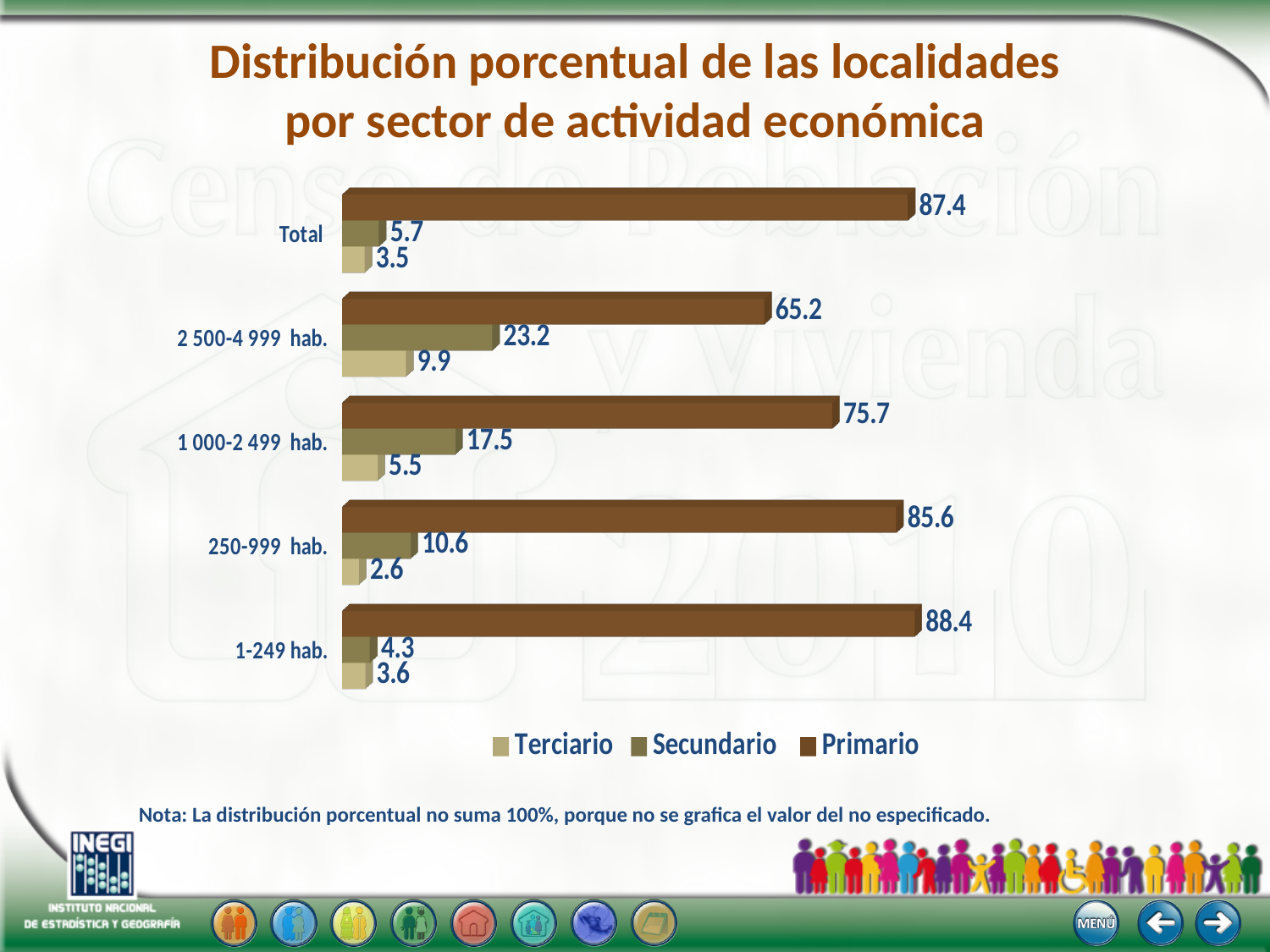
What is the Primario value for localities of 1 000-2 499 hab.? 75.7 How many series does the legend list? 3 Which is larger: the Secundario value for 1 000-2 499 hab. or the Secundario value for 250-999 hab.? 1 000-2 499 hab. What is the Primario value for the Total category? 87.4 Which series is shown in dark brown in the legend? Primario What is the Secundario value for localities of 2 500-4 999 hab.? 23.2 What is the Terciario value for localities of 250-999 hab.? 2.6 Which locality size category has the lowest Primario value? 2 500-4 999 hab. What is the difference between the Primario values for 1-249 hab. and 2 500-4 999 hab.? 23.2 What kind of chart is shown on the slide? Bar chart How many locality size categories are shown on the chart? 4 Which locality size category has the highest Primario value? 1-249 hab.